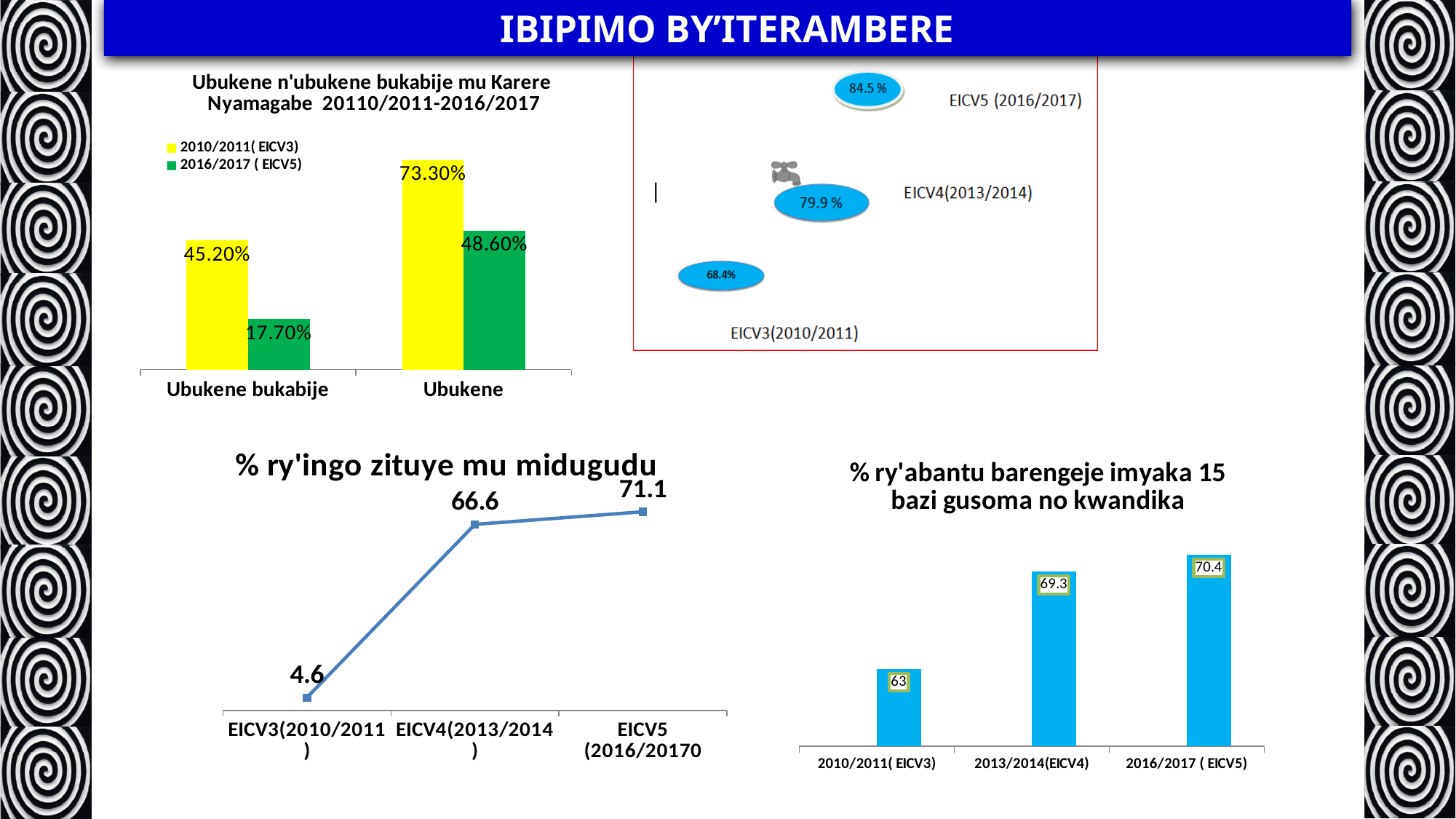
In the chart titled "% ry'abantu barengeje imyaka 15 bazi gusoma no kwandika", which period has the lowest value? 2010/2011 (EICV3) In the chart titled "Ubukene n'ubukene bukabije mu Karere Nyamagabe", what is the value for Ubukene in 2016/2017 (EICV5)? 48.60% In the chart titled "% ry'abantu barengeje imyaka 15 bazi gusoma no kwandika", what is the value for 2013/2014 (EICV4)? 69.3 In the chart titled "% ry'ingo zituye mu midugudu", what kind of chart is shown? Line chart In the chart titled "% ry'ingo zituye mu midugudu", do the values rise or fall from EICV3 to EICV5? Rise In the chart titled "Ubukene n'ubukene bukabije mu Karere Nyamagabe", which colour represents 2016/2017 (EICV5)? Green In the chart titled "% ry'ingo zituye mu midugudu", what is the difference between the EICV5 and EICV3 values? 66.5 In the top-right diagram, what is the value shown for EICV4 (2013/2014)? 79.9 % In the chart titled "Ubukene n'ubukene bukabije mu Karere Nyamagabe", what is the value for Ubukene bukabije in 2010/2011 (EICV3)? 45.20% In the chart titled "Ubukene n'ubukene bukabije mu Karere Nyamagabe", by how much did Ubukene bukabije fall from 2010/2011 to 2016/2017? 27.50% In the chart titled "% ry'ingo zituye mu midugudu", what is the value for EICV4 (2013/2014)? 66.6 In the chart titled "Ubukene n'ubukene bukabije mu Karere Nyamagabe", how many series does the legend list? 2